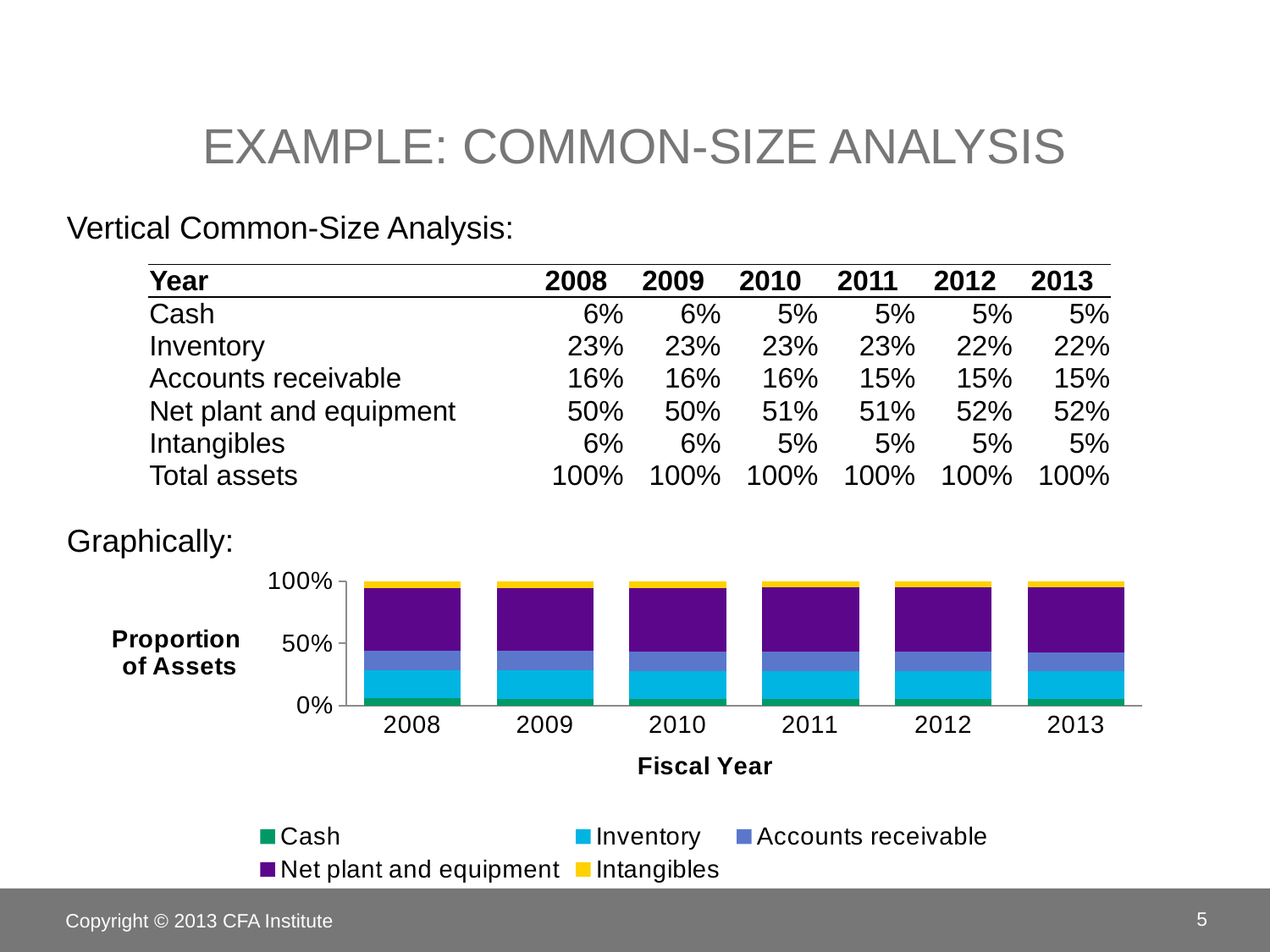
What proportion of assets does Cash represent in 2010? 5% What proportion of assets does Net plant and equipment represent in 2013? 52% Is the Net plant and equipment share in 2011 greater or less than 50%? greater What kind of chart is shown on the slide? stacked bar chart What is the difference between the Net plant and equipment share in 2013 and in 2008? 2% How many series does the chart's legend list? 5 Which series is shown in purple in the chart? Net plant and equipment How many fiscal years are shown on the x axis of the chart? 6 Does the Net plant and equipment share rise or fall from 2008 to 2013? rise What proportion of assets does Inventory represent in 2008? 23% Which series makes up the largest share of assets in 2012? Net plant and equipment What is the x-axis title of the chart? Fiscal Year